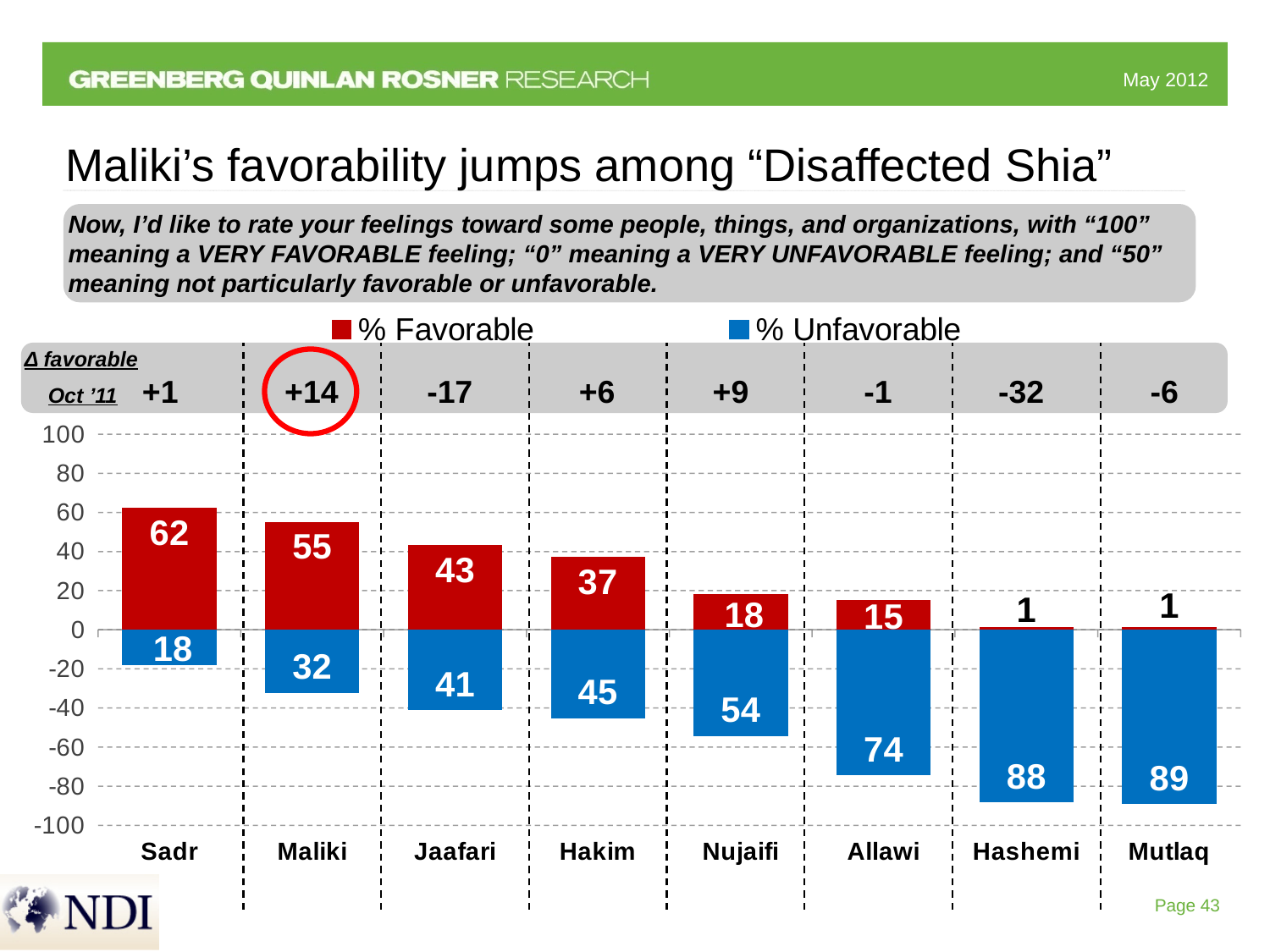
What is the % Unfavorable value for Nujaifi? 54 Is the % Unfavorable value for Allawi greater or less than 60? greater What is the Δ favorable value shown for Hashemi? -32 What is the difference between the % Favorable values for Sadr and Maliki? 7 Which person has the lowest % Unfavorable value? Sadr What is the % Unfavorable value for Hashemi? 88 What kind of chart is shown on the slide? bar chart How many people are shown on the x axis of the chart? 8 What is the % Favorable value for Maliki? 55 Which is larger, the % Unfavorable value for Jaafari or for Hakim? Hakim How many series does the legend list? 2 Which person has the highest % Favorable value? Sadr